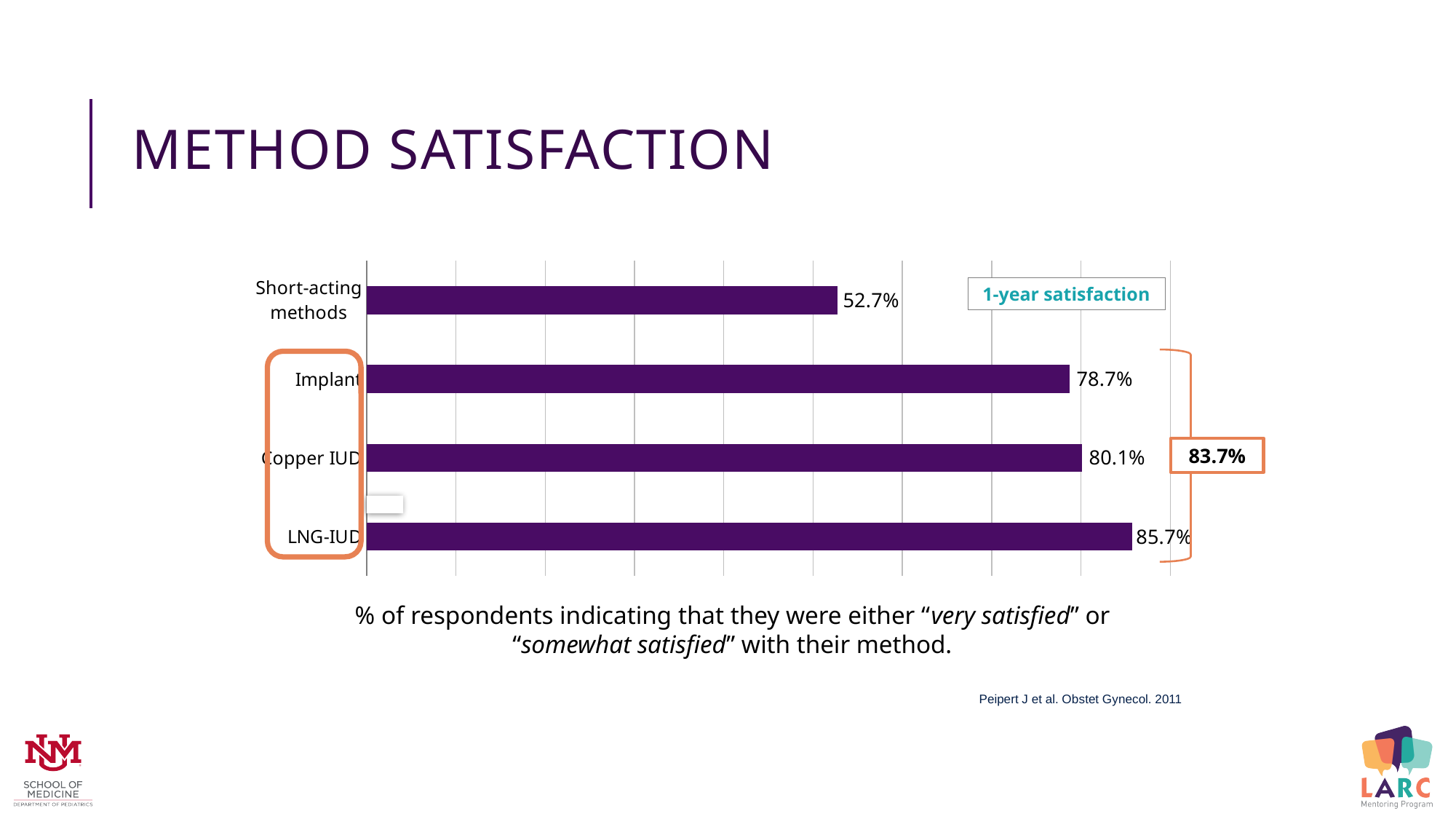
What combined satisfaction value is shown in the orange box next to the bracketed LARC methods? 83.7% How many methods are shown in the chart? 4 Which method has the highest 1-year satisfaction? LNG-IUD Which has a higher 1-year satisfaction, Implant or Short-acting methods? Implant What is the 1-year satisfaction value for Implant? 78.7% What is the 1-year satisfaction value for LNG-IUD? 85.7% What is the difference in 1-year satisfaction between LNG-IUD and Short-acting methods? 33 percentage points What is the difference in 1-year satisfaction between Copper IUD and Implant? 1.4 percentage points What type of chart is shown on the slide? Bar chart Which method has the lowest 1-year satisfaction? Short-acting methods What is the 1-year satisfaction value for Short-acting methods? 52.7% What is the 1-year satisfaction value for Copper IUD? 80.1%